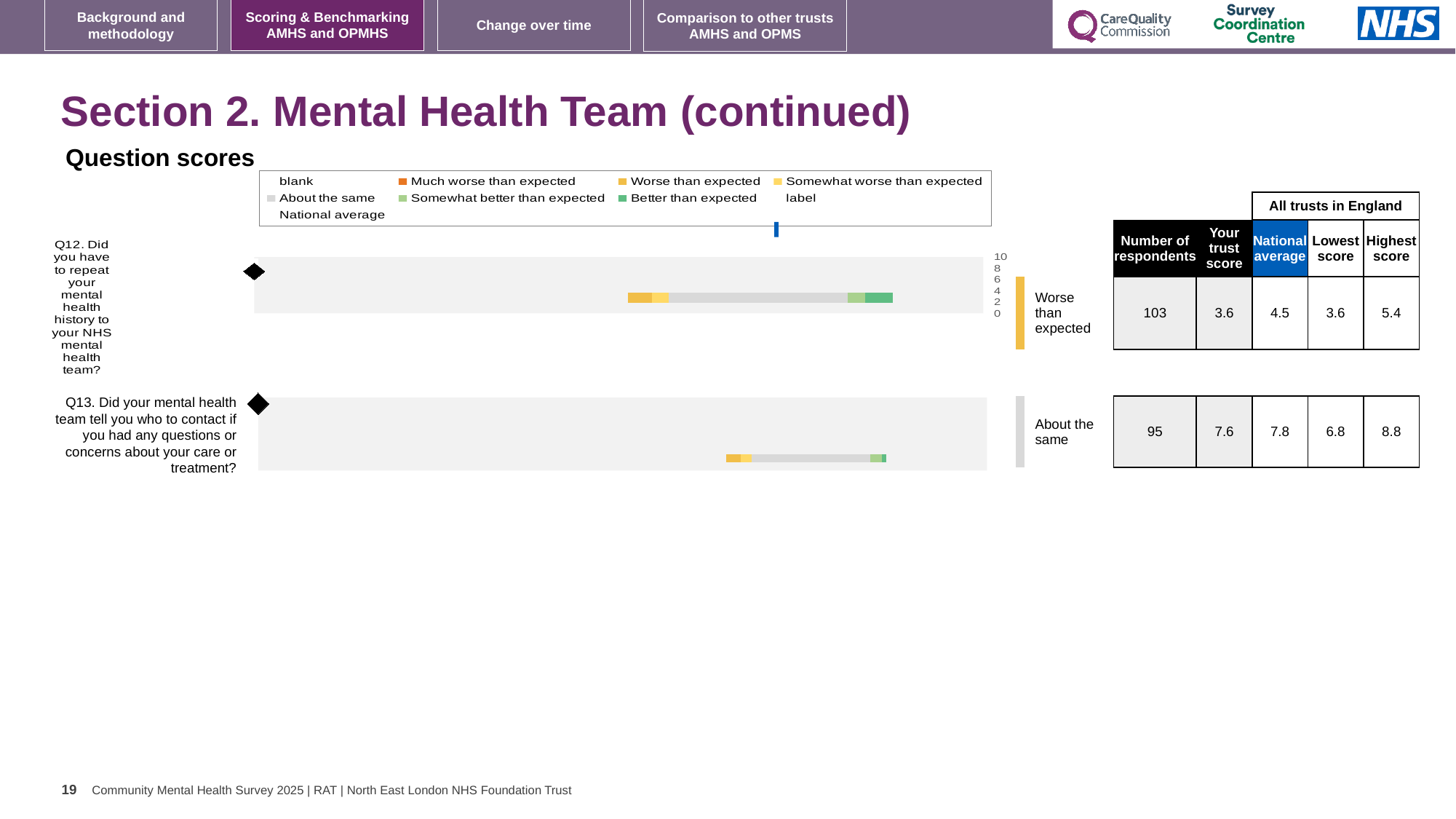
What is the difference between the highest score and the lowest score for Q13? 2.0 How many respondents answered Q13? 95 What kind of chart is used to show the question scores on this slide? bar chart How many questions (Q12 and Q13) are plotted on the slide? 2 Which question has the higher trust score, Q12 or Q13? Q13 What is the rating label shown next to the Q12 bar? Worse than expected What is the rating label shown next to the Q13 bar? About the same What is the trust score for Q13 (told who to contact with questions or concerns)? 7.6 What is the trust score for Q12 (repeating mental health history)? 3.6 Is the trust score for Q12 greater or less than 4? less What is the national average for Q12? 4.5 What is the difference between the national average and the trust score for Q12? 0.9